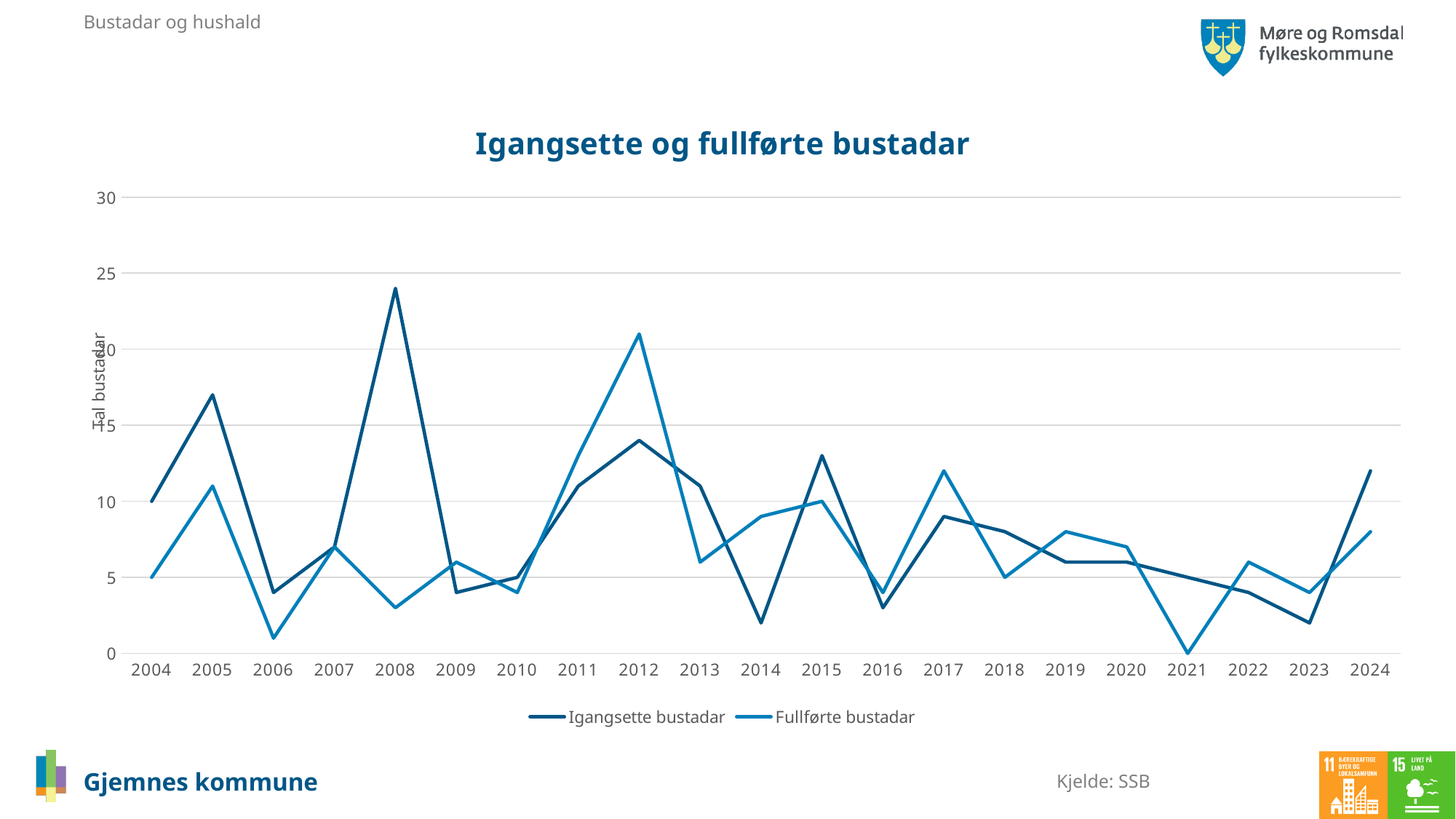
In which year is Igangsette bustadar highest? 2008 What type of chart is shown on the slide? Line chart In 2012, which series has the larger value, Igangsette bustadar or Fullførte bustadar? Fullførte bustadar What is the title of the chart? Igangsette og fullførte bustadar How many years are shown on the x axis? 21 In which year is Fullførte bustadar lowest? 2021 Is the value for Igangsette bustadar in 2008 greater or less than 20? greater How many series does the legend list? 2 What is the value for Igangsette bustadar in 2004? 10 What is the value for Fullførte bustadar in 2021? 0 What is the value for Fullførte bustadar in 2015? 10 In which year is Fullførte bustadar highest? 2012